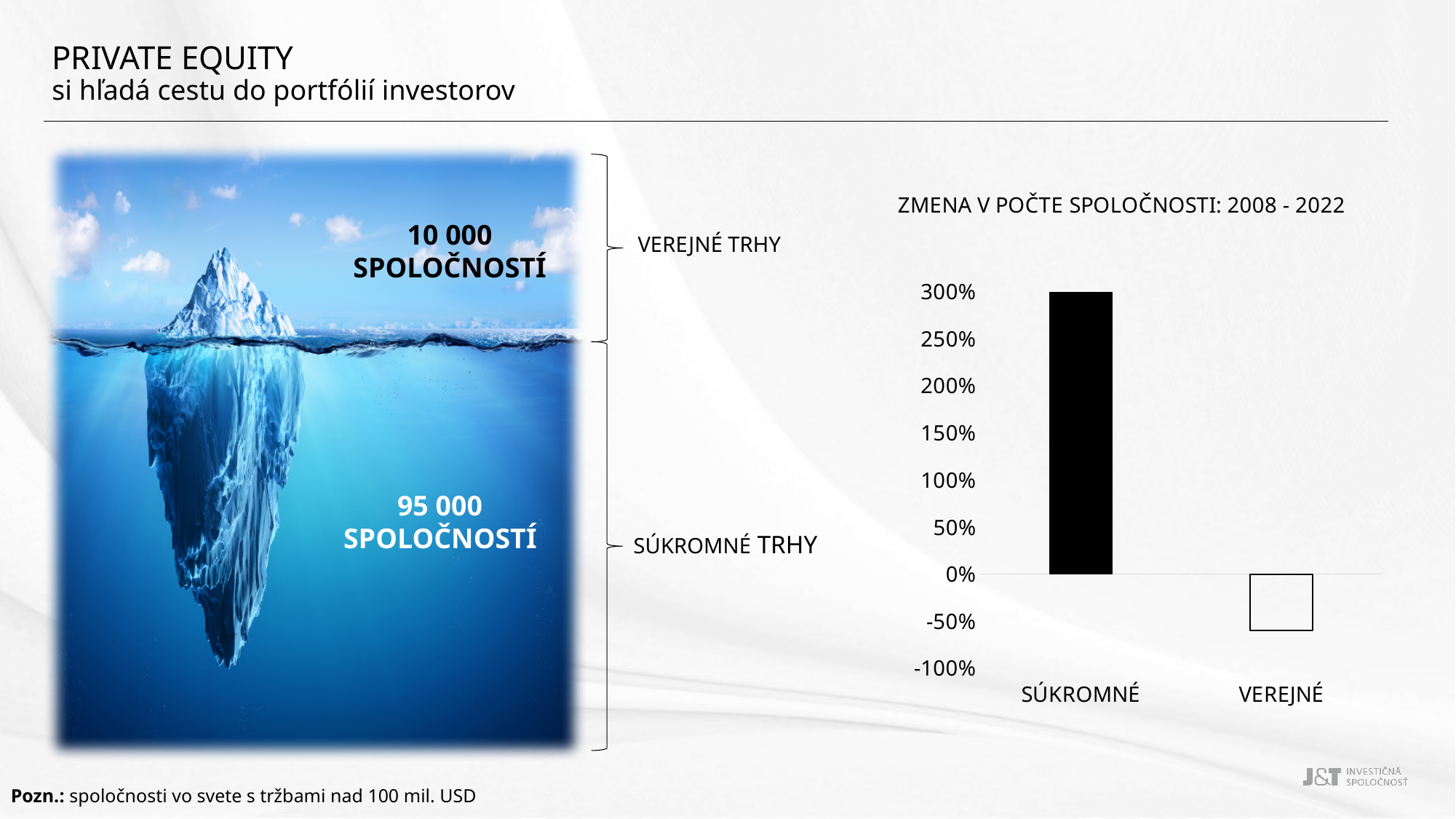
What kind of chart is shown under the title 'ZMENA V POČTE SPOLOČNOSTI: 2008 - 2022'? bar chart Which category's bar is filled solid black in the bar chart? SÚKROMNÉ Is the value for VEREJNÉ greater or less than -50%? less In the bar chart, which is larger, the value for SÚKROMNÉ or the value for VEREJNÉ? SÚKROMNÉ Do the values in the bar chart rise or fall from SÚKROMNÉ to VEREJNÉ? fall Is the value for VEREJNÉ greater or less than -100%? greater How many categories are plotted in the bar chart? 2 Is the value for VEREJNÉ greater or less than 0%? less Which category has the lowest value in the bar chart? VEREJNÉ What is the title of the bar chart on the right of the slide? ZMENA V POČTE SPOLOČNOSTI: 2008 - 2022 Which category has the highest value in the bar chart? SÚKROMNÉ